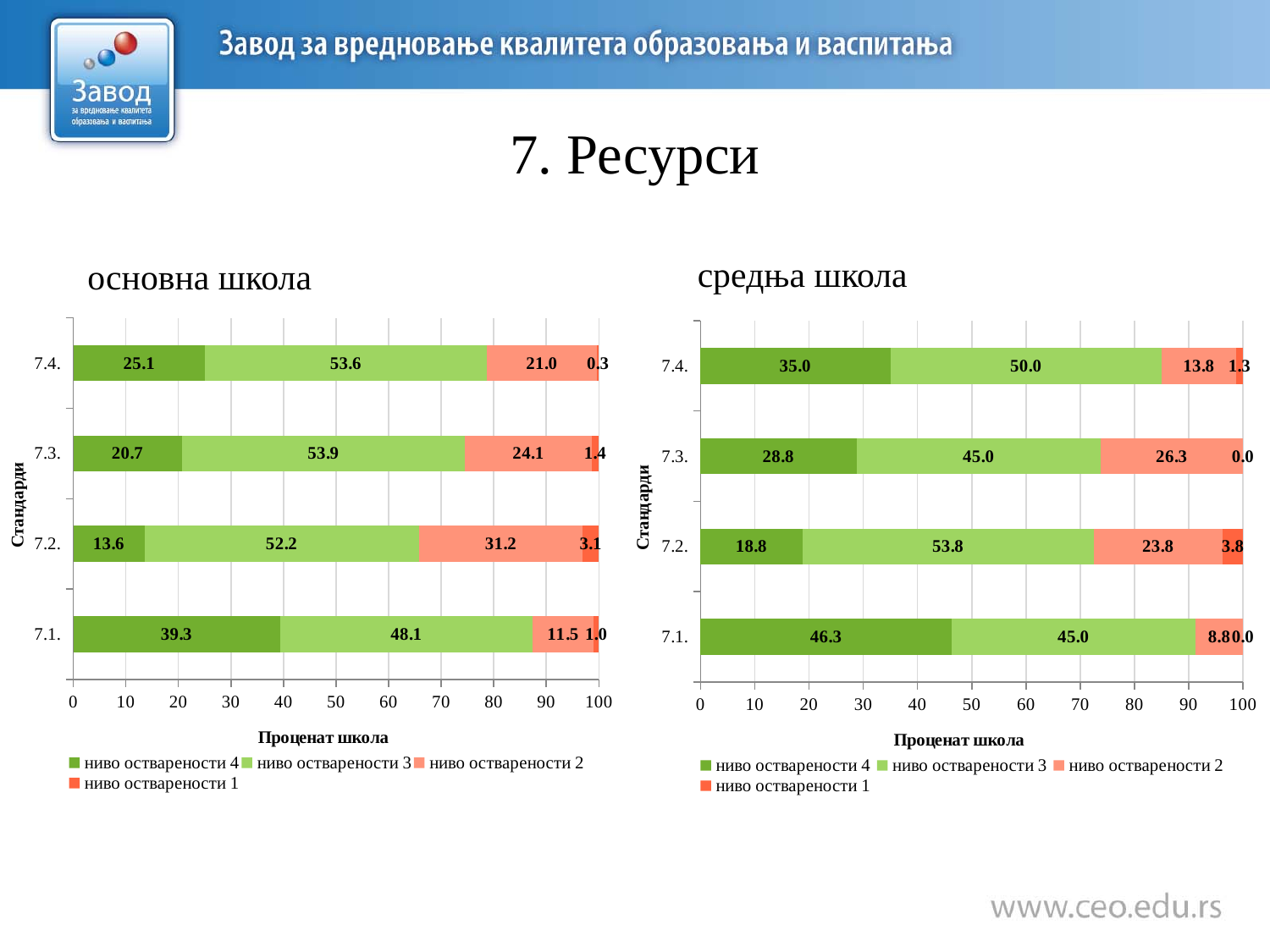
In the 'основна школа' chart, which standard has the highest value for 'ниво остварености 2'? 7.2. In the 'средња школа' chart, which standard has the lowest value for 'ниво остварености 4'? 7.2. In the 'основна школа' chart, what is the difference between the 'ниво остварености 3' values for standards 7.3. and 7.1.? 5.8 In the 'средња школа' chart, which is larger: 'ниво остварености 4' for 7.4. or for 7.3.? 7.4. What is the x-axis title of the 'средња школа' chart? Проценат школа In the 'основна школа' chart, what is the value of 'ниво остварености 1' for standard 7.2.? 3.1 In the 'средња школа' chart, what is the total of the 'ниво остварености 4' and 'ниво остварености 3' segments for standard 7.1.? 91.3 In the 'основна школа' chart, what is the value of 'ниво остварености 4' for standard 7.1.? 39.3 In the 'средња школа' chart, what is the value of 'ниво остварености 2' for standard 7.3.? 26.3 How many series does the legend of the 'средња школа' chart list? 4 How many standards (categories) are shown in the 'основна школа' chart? 4 What type of chart is the 'основна школа' chart? Stacked bar chart